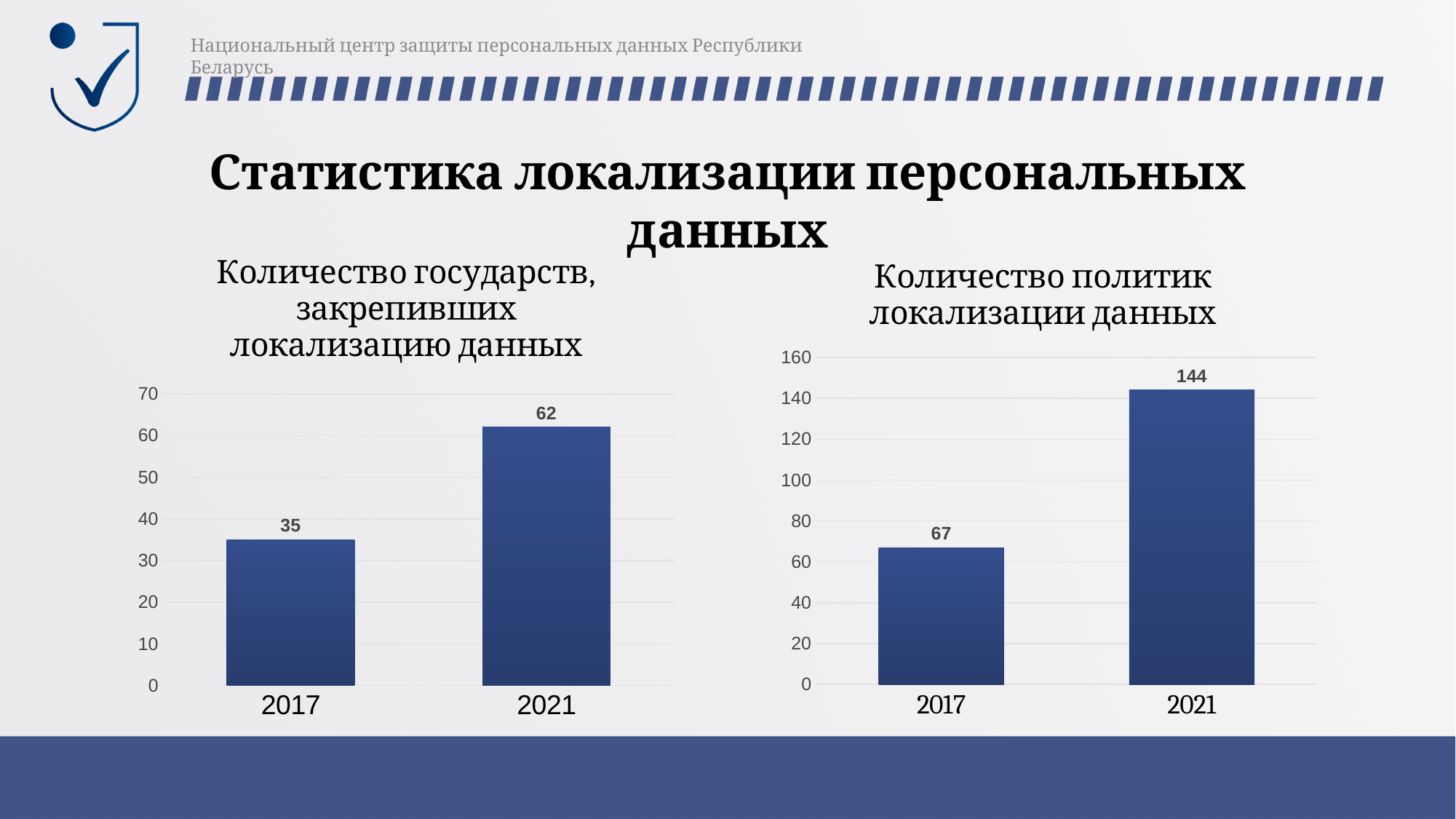
In the left chart 'Количество государств, закрепивших локализацию данных', what is the difference between the 2021 and 2017 values? 27 In the right chart 'Количество политик локализации данных', which year has the highest value? 2021 In the left chart 'Количество государств, закрепивших локализацию данных', which year has the lowest value? 2017 In the left chart 'Количество государств, закрепивших локализацию данных', do the values rise or fall from 2017 to 2021? rise How many categories are shown on the x axis of the left chart 'Количество государств, закрепивших локализацию данных'? 2 In the left chart 'Количество государств, закрепивших локализацию данных', what is the value for 2017? 35 In the right chart 'Количество политик локализации данных', what is the value for 2021? 144 In the right chart 'Количество политик локализации данных', what is the value for 2017? 67 In the left chart 'Количество государств, закрепивших локализацию данных', what is the value for 2021? 62 In the right chart 'Количество политик локализации данных', is the value for 2021 greater or less than 140? greater In the right chart 'Количество политик локализации данных', what is the difference between the 2021 and 2017 values? 77 What kind of chart is the right chart 'Количество политик локализации данных'? bar chart